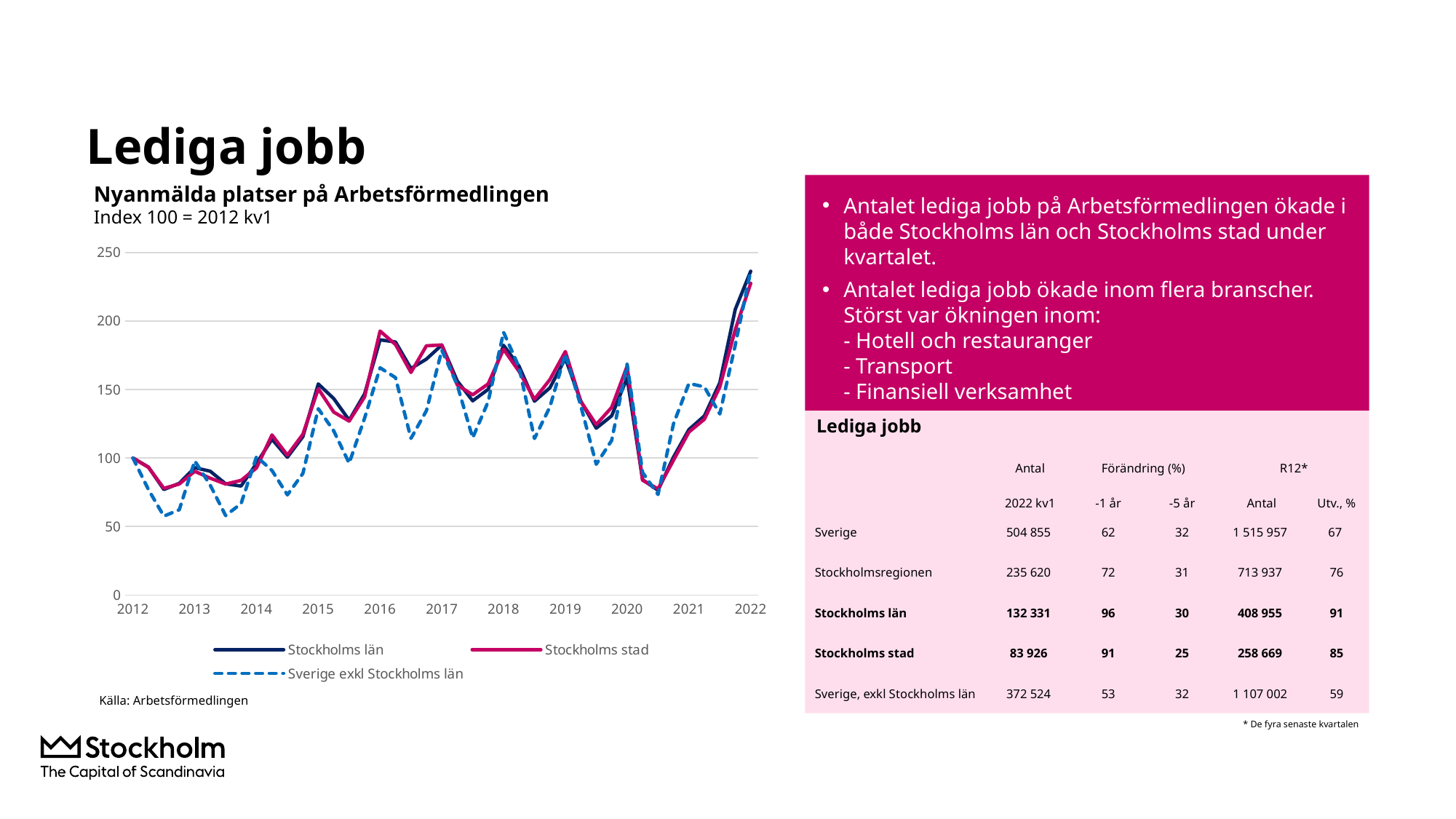
What kind of chart is shown on the slide? line chart What is the index value of all three series at 2012 kv1? 100 In mid-2021, which is higher: Sverige exkl Stockholms län or Stockholms län? Sverige exkl Stockholms län How many series does the chart legend list? 3 Overall, do the index values rise or fall from 2012 to 2022? rise Which series is drawn with a dashed line in the chart? Sverige exkl Stockholms län Is the value for Stockholms län at the end of 2022 greater or less than 200? greater Is the value for Sverige exkl Stockholms län in late 2012 greater or less than 100? less Is the value for Stockholms stad at its 2016 peak greater or less than 150? greater Which series has the lowest value in late 2012? Sverige exkl Stockholms län How many year labels are shown on the x axis of the chart? 11 What is the title of the chart? Nyanmälda platser på Arbetsförmedlingen